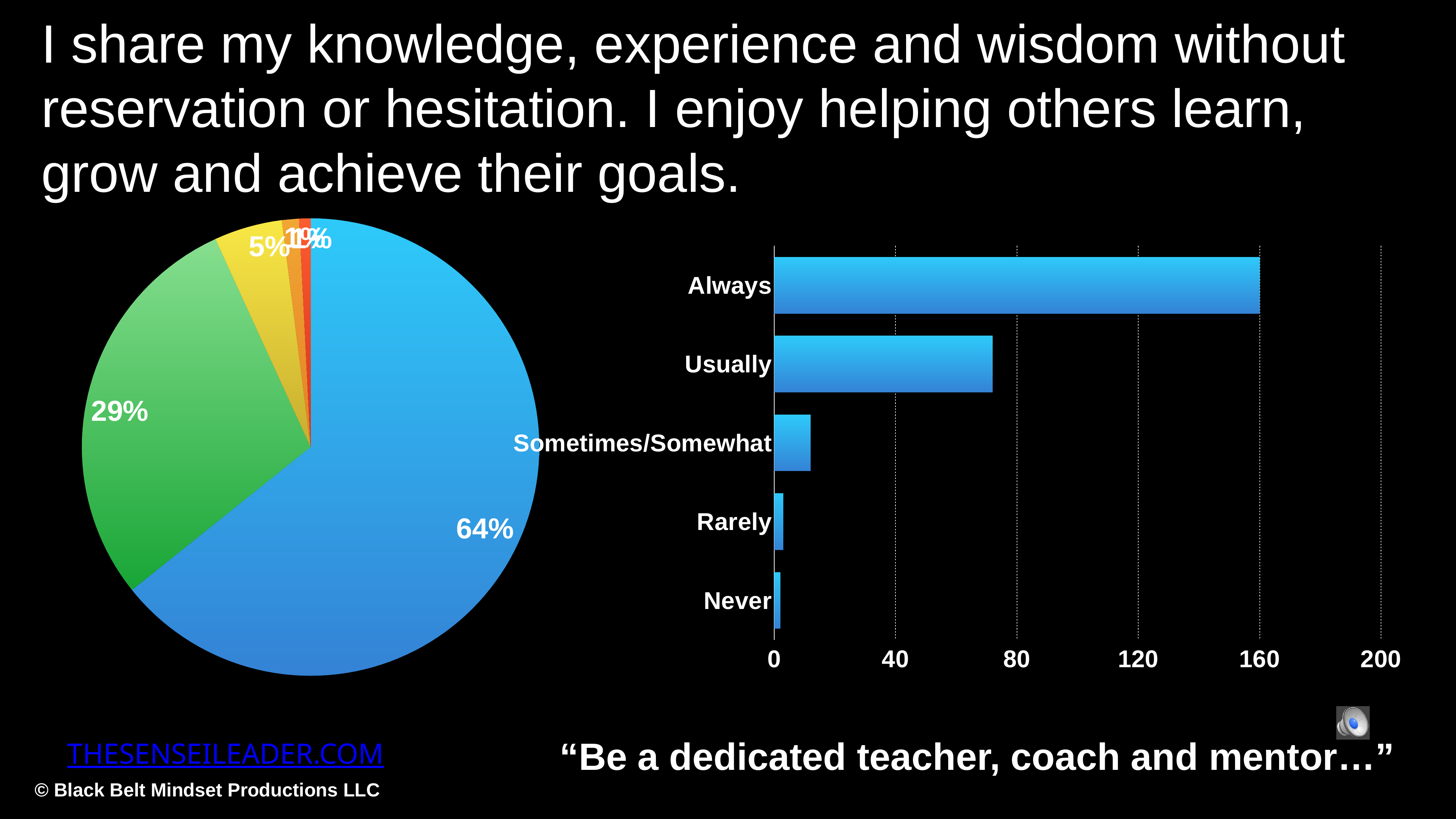
In the bar chart on the right, is the value for Usually greater or less than 80? less In the bar chart on the right, which is larger, the value for Usually or the value for Sometimes/Somewhat? Usually In the bar chart on the right, what is the value for Always? 160 In the pie chart on the left, what share does the yellow slice have? 5% How many categories does the bar chart on the right show? 5 What kind of chart is the chart on the left of the slide? pie chart What kind of chart is the chart on the right of the slide? bar chart In the pie chart on the left, what share does the green slice have? 29% How many slices does the pie chart on the left have? 5 In the pie chart on the left, what share does the largest slice have? 64% In the bar chart on the right, is the value for Sometimes/Somewhat greater or less than 40? less In the bar chart on the right, which category has the highest value? Always